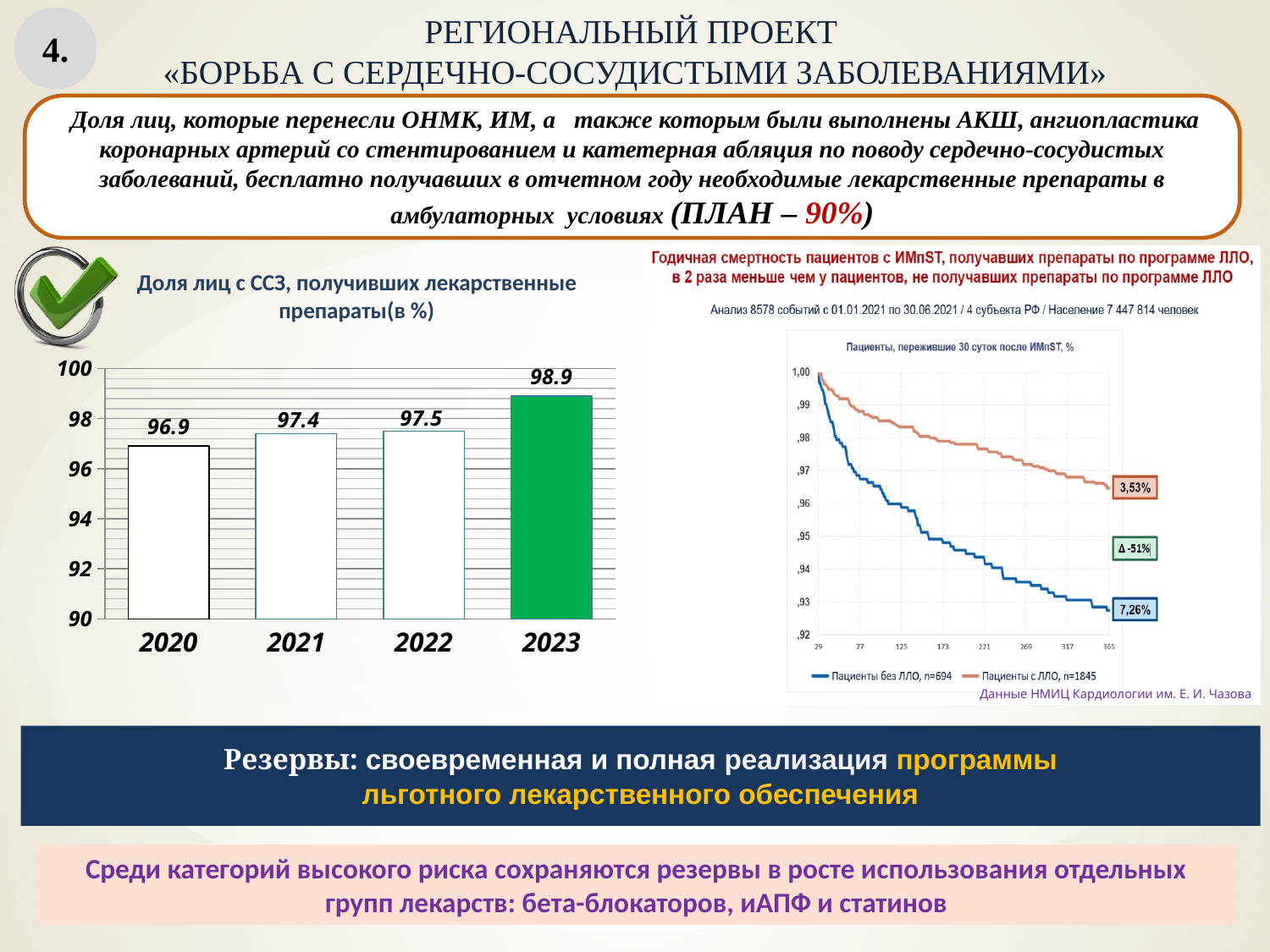
In the bar chart 'Доля лиц с ССЗ, получивших лекарственные препараты (в %)', what is the difference between the 2023 and 2020 values? 2.0 In the line chart on the right ('Пациенты, пережившие 30 суток после ИМпST, %'), what percentage label is shown at the end of the 'Пациенты без ЛЛО' line? 7,26% In the bar chart 'Доля лиц с ССЗ, получивших лекарственные препараты (в %)', do the values rise or fall from 2020 to 2023? rise In the line chart on the right ('Пациенты, пережившие 30 суток после ИМпST, %'), how many series does the legend list? 2 In the bar chart 'Доля лиц с ССЗ, получивших лекарственные препараты (в %)', what is the value for 2023? 98.9 In the bar chart 'Доля лиц с ССЗ, получивших лекарственные препараты (в %)', how many years are shown? 4 In the bar chart 'Доля лиц с ССЗ, получивших лекарственные препараты (в %)', what is the value for 2021? 97.4 In the bar chart 'Доля лиц с ССЗ, получивших лекарственные препараты (в %)', which year has the lowest value? 2020 What kind of chart is the left chart 'Доля лиц с ССЗ, получивших лекарственные препараты (в %)'? bar chart In the bar chart 'Доля лиц с ССЗ, получивших лекарственные препараты (в %)', what is the difference between the 2022 and 2021 values? 0.1 In the bar chart 'Доля лиц с ССЗ, получивших лекарственные препараты (в %)', what is the value for 2020? 96.9 In the bar chart 'Доля лиц с ССЗ, получивших лекарственные препараты (в %)', which year has the highest value? 2023